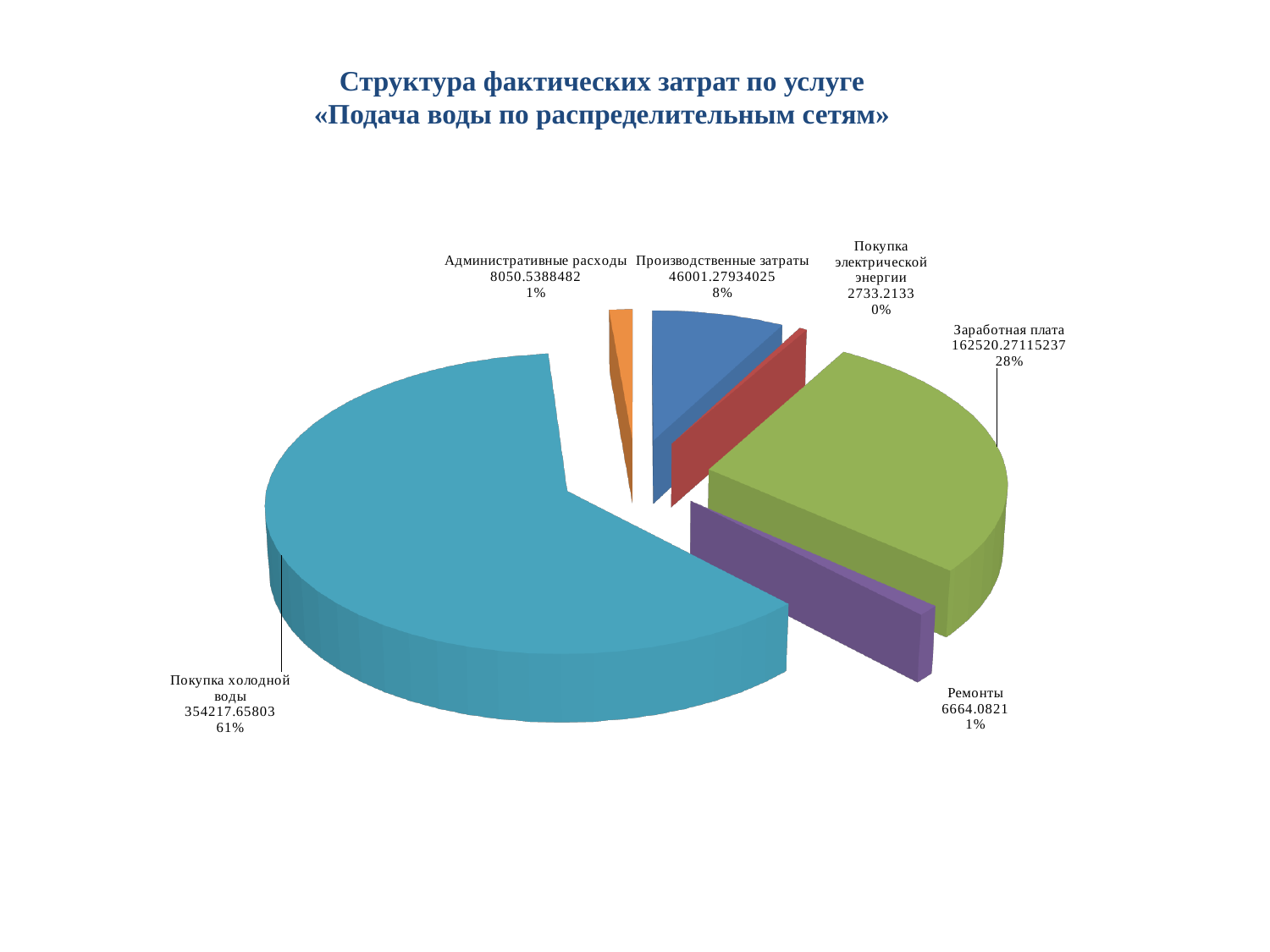
Which category has the largest slice? Покупка холодной воды What kind of chart is shown on the slide? pie chart What share of the pie does Покупка холодной воды represent? 61% What share of the pie does Заработная плата represent? 28% What is the difference between the values for Покупка холодной воды and Заработная плата? 191697.38687763 Which category has the smallest slice? Покупка электрической энергии What is the value for Заработная плата? 162520.27115237 Which is larger, the value for Ремонты or the value for Административные расходы? Административные расходы What is the value for Покупка электрической энергии? 2733.2133 What is the value for Покупка холодной воды? 354217.65803 What is the value for Производственные затраты? 46001.27934025 How many slices does the pie chart have? 6